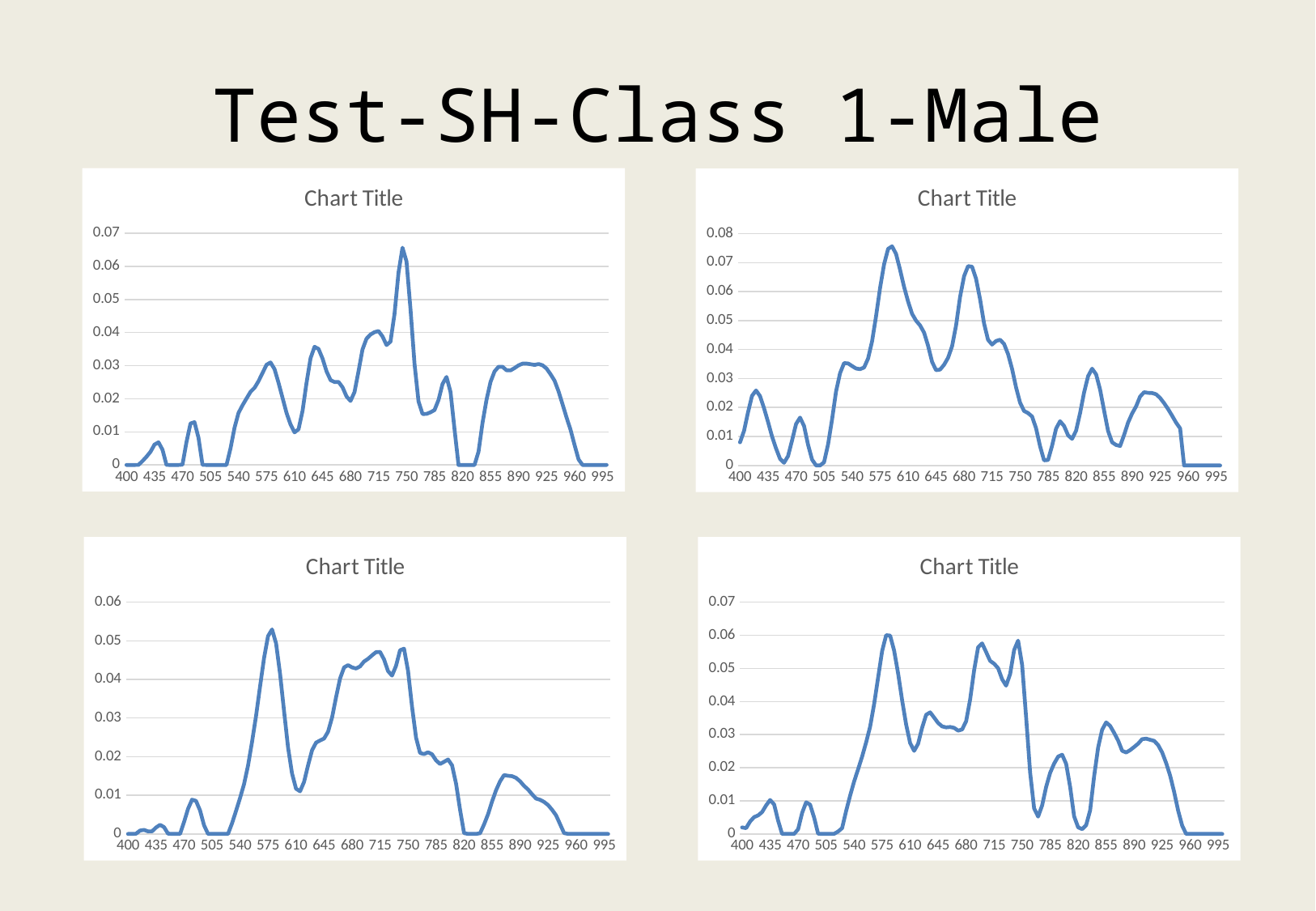
How many charts are shown on the slide? 4 What is the title shown above the bottom-right chart? Chart Title In the top-left chart, is the value at 750 greater or less than 0.06? greater In the bottom-right chart, is the value at 820 greater or less than 0.01? less In the top-left chart, how many labelled categories are on the x axis? 18 In the top-right chart, is the value at 680 greater or less than 0.06? greater What kind of chart is the top-left chart? line chart